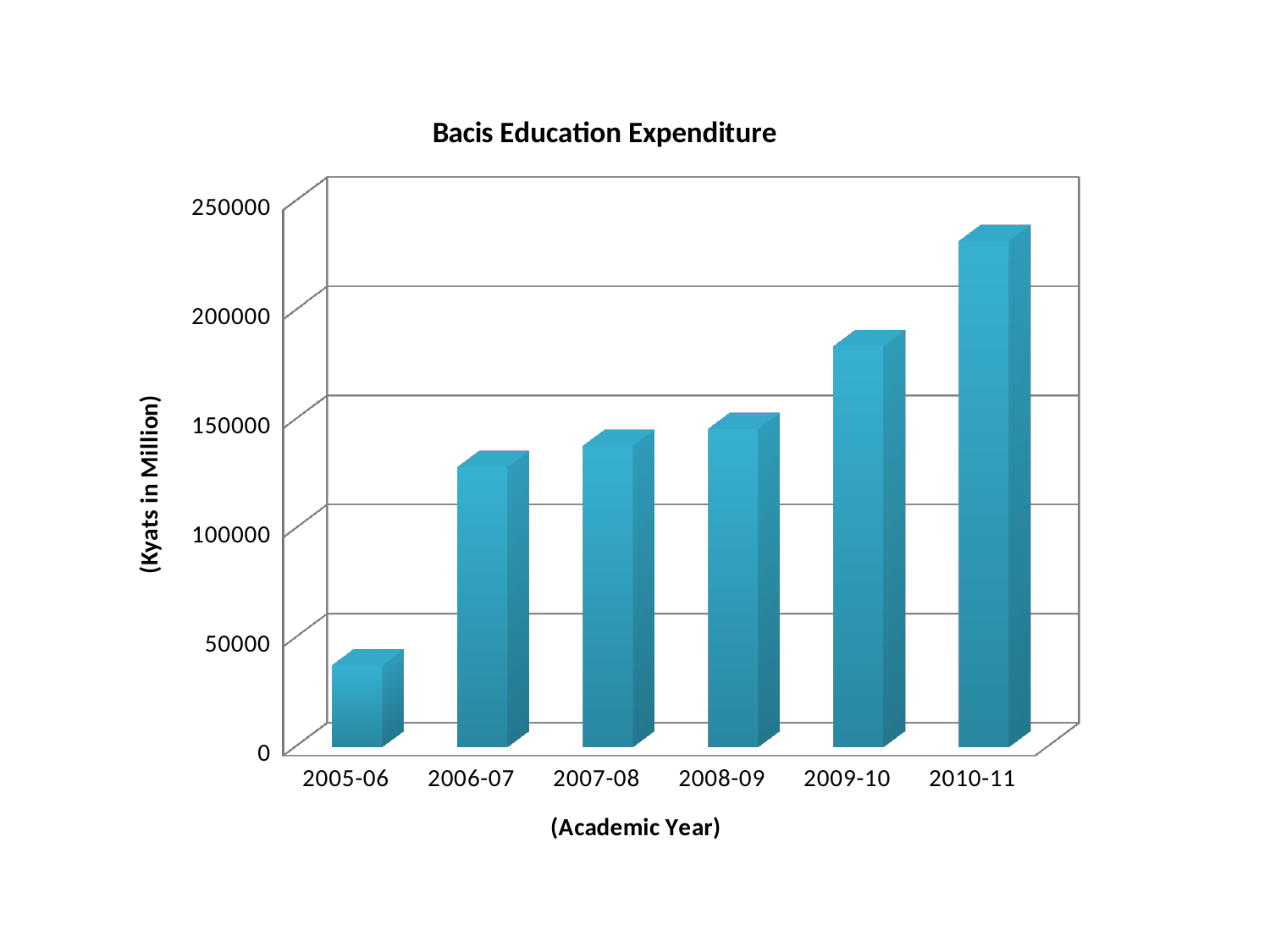
How many academic years are plotted on the chart? 6 Is the value for 2010-11 greater or less than 200000? greater Is the value for 2006-07 greater or less than 100000? greater Which academic year has the highest education expenditure? 2010-11 Is the value for 2009-10 greater or less than 150000? greater Which is larger, the expenditure for 2009-10 or for 2006-07? 2009-10 What kind of chart is shown on the slide? bar chart Do the expenditure values rise or fall from 2005-06 to 2010-11? rise Which academic year has the lowest education expenditure? 2005-06 What is the label on the vertical axis of the chart? (Kyats in Million) What is the title of the chart? Bacis Education Expenditure